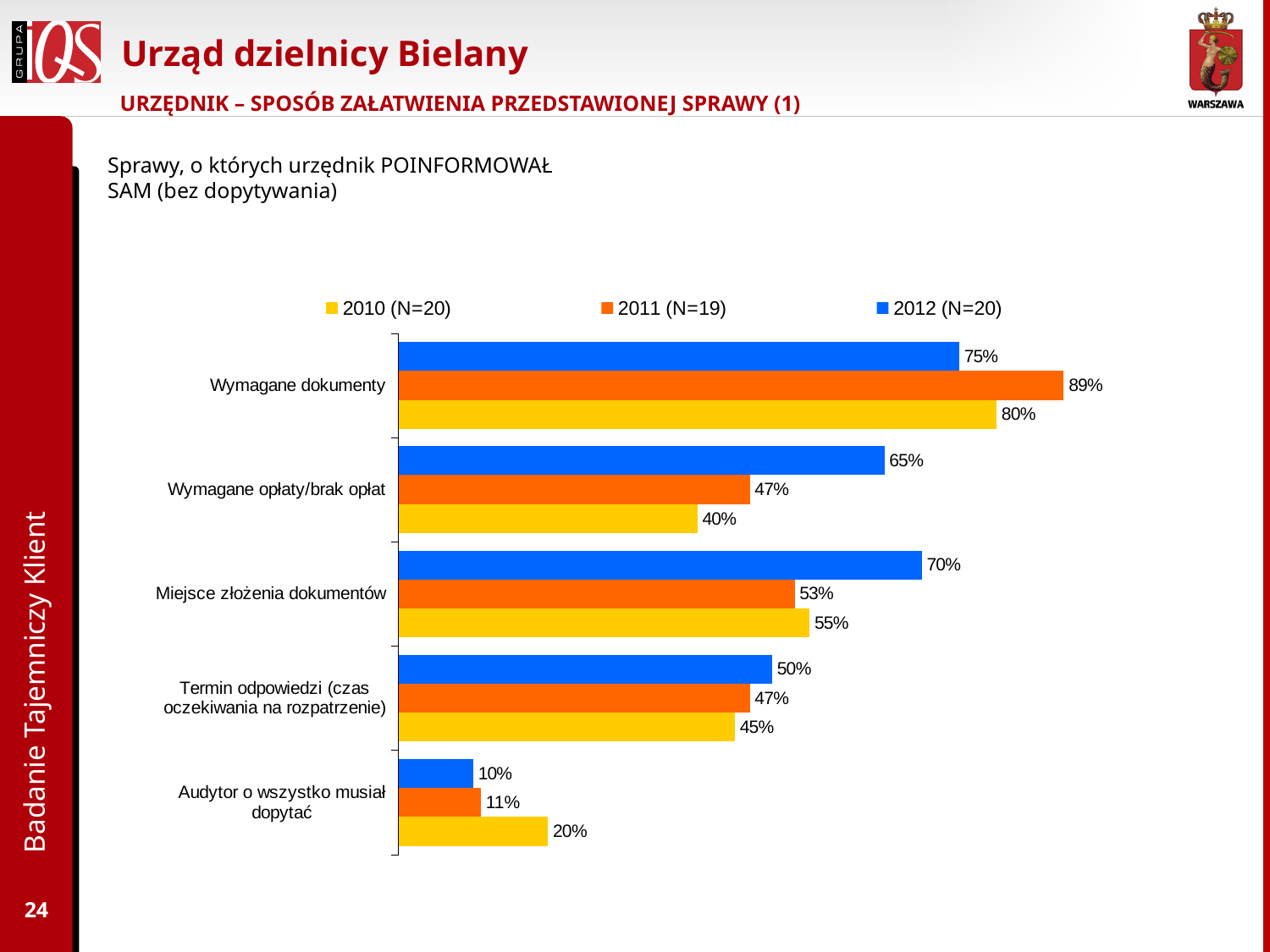
What is the 2011 (N=19) value for Wymagane opłaty/brak opłat? 47% What is the 2012 (N=20) value for Wymagane dokumenty? 75% How many categories are shown on the chart? 5 What is the 2011 (N=19) value for Termin odpowiedzi (czas oczekiwania na rozpatrzenie)? 47% What is the difference between the 2012 (N=20) and 2010 (N=20) values for Wymagane opłaty/brak opłat? 25% What is the 2010 (N=20) value for Audytor o wszystko musiał dopytać? 20% Which category has the highest 2011 (N=19) value? Wymagane dokumenty For Miejsce złożenia dokumentów, which is larger: the 2010 (N=20) value or the 2011 (N=19) value? 2010 (N=20) Which category has the lowest 2012 (N=20) value? Audytor o wszystko musiał dopytać How many series does the legend list? 3 What kind of chart is shown on the slide? Bar chart Which colour represents the 2012 (N=20) series in the legend? Blue